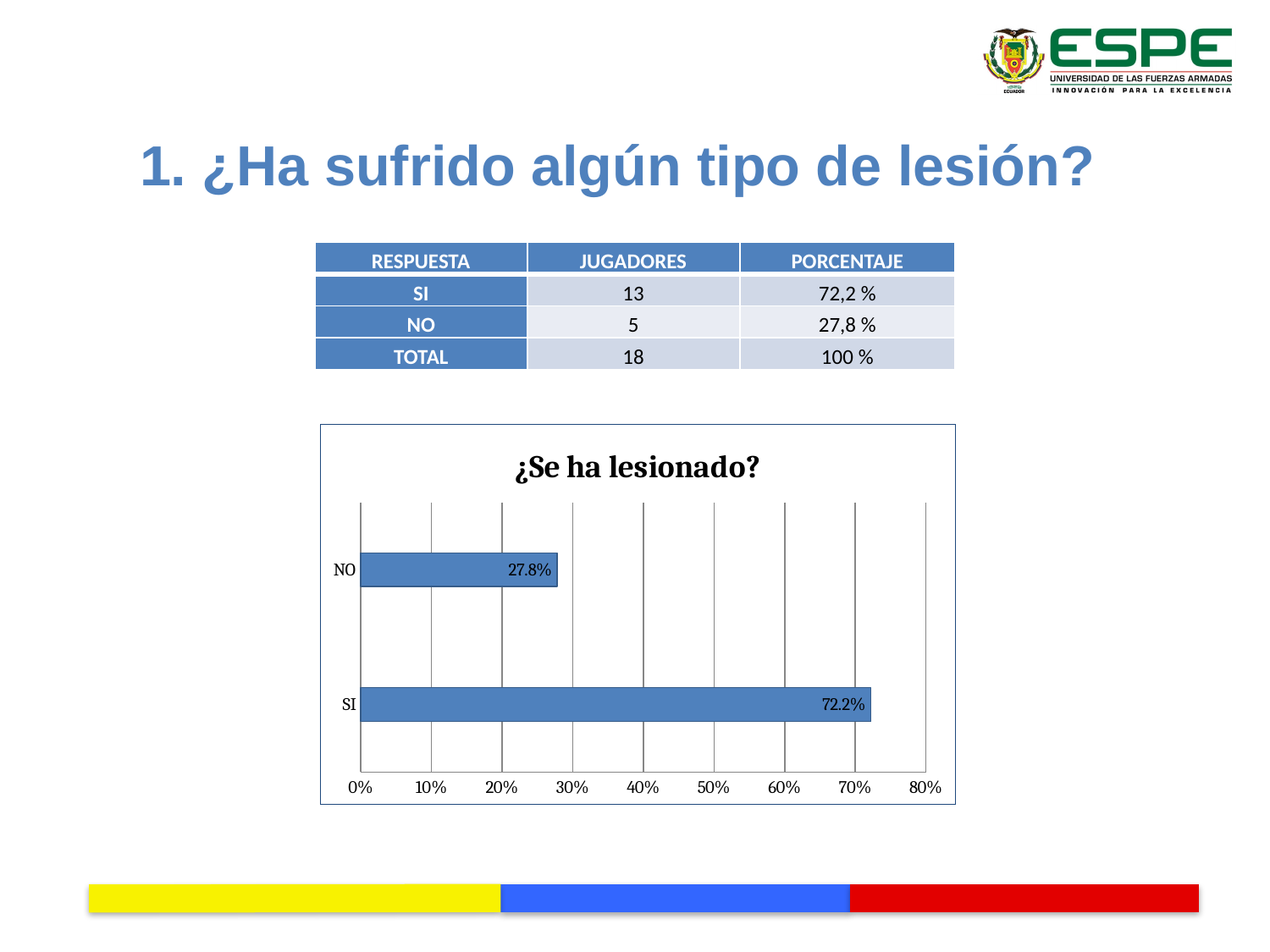
Is the value for NO greater or less than 30%? less What is the maximum value shown on the x axis of the chart? 80% What kind of chart is shown on the slide? bar chart Which category has the highest value in the chart? SI Which is larger in the chart, the value for SI or the value for NO? SI What is the title of the chart? ¿Se ha lesionado? What is the value for SI in the chart? 72.2% What is the value for NO in the chart? 27.8% Is the value for SI greater or less than 50%? greater Which category has the lowest value in the chart? NO How many categories are shown in the chart? 2 What is the difference between the values for SI and NO in the chart? 44.4%